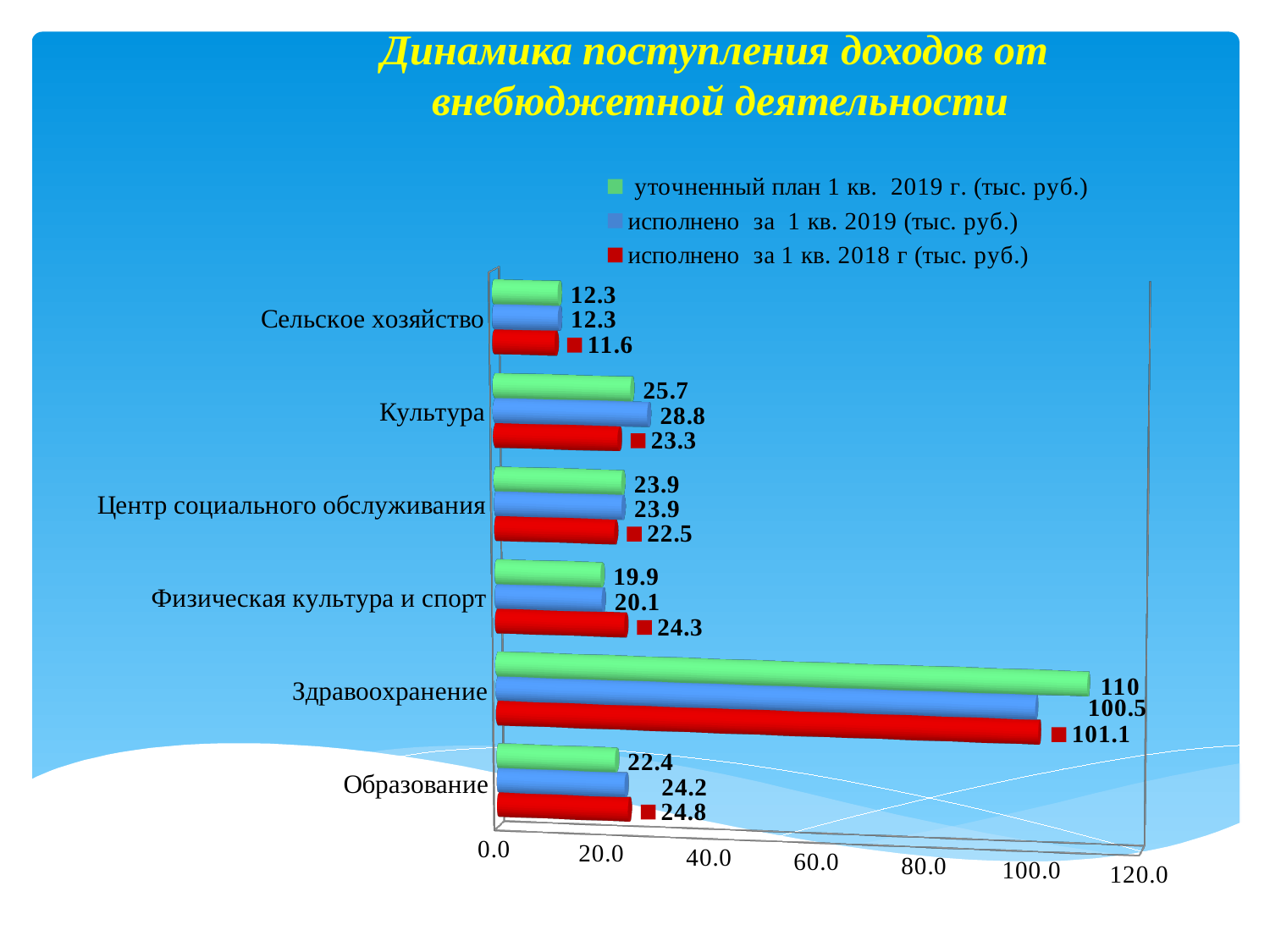
What is the difference between 'исполнено за 1 кв. 2019' and 'исполнено за 1 кв. 2018 г' for Культура? 5.5 What is the value of 'исполнено за 1 кв. 2018 г' for Культура? 23.3 Which category has the lowest value for 'исполнено за 1 кв. 2018 г'? Сельское хозяйство What is the value of 'уточненный план 1 кв. 2019 г.' for Здравоохранение? 110 For Физическая культура и спорт, which is larger: 'исполнено за 1 кв. 2019' or 'исполнено за 1 кв. 2018 г'? исполнено за 1 кв. 2018 г What type of chart is shown on the slide? bar chart Which category has the highest value for 'исполнено за 1 кв. 2019'? Здравоохранение What is the value of 'исполнено за 1 кв. 2019' for Образование? 24.2 Is the value of 'исполнено за 1 кв. 2018 г' for Здравоохранение greater or less than 100.0? greater Which colour represents 'уточненный план 1 кв. 2019 г.' in the legend? green How many series does the legend list? 3 How many categories are shown on the chart? 6